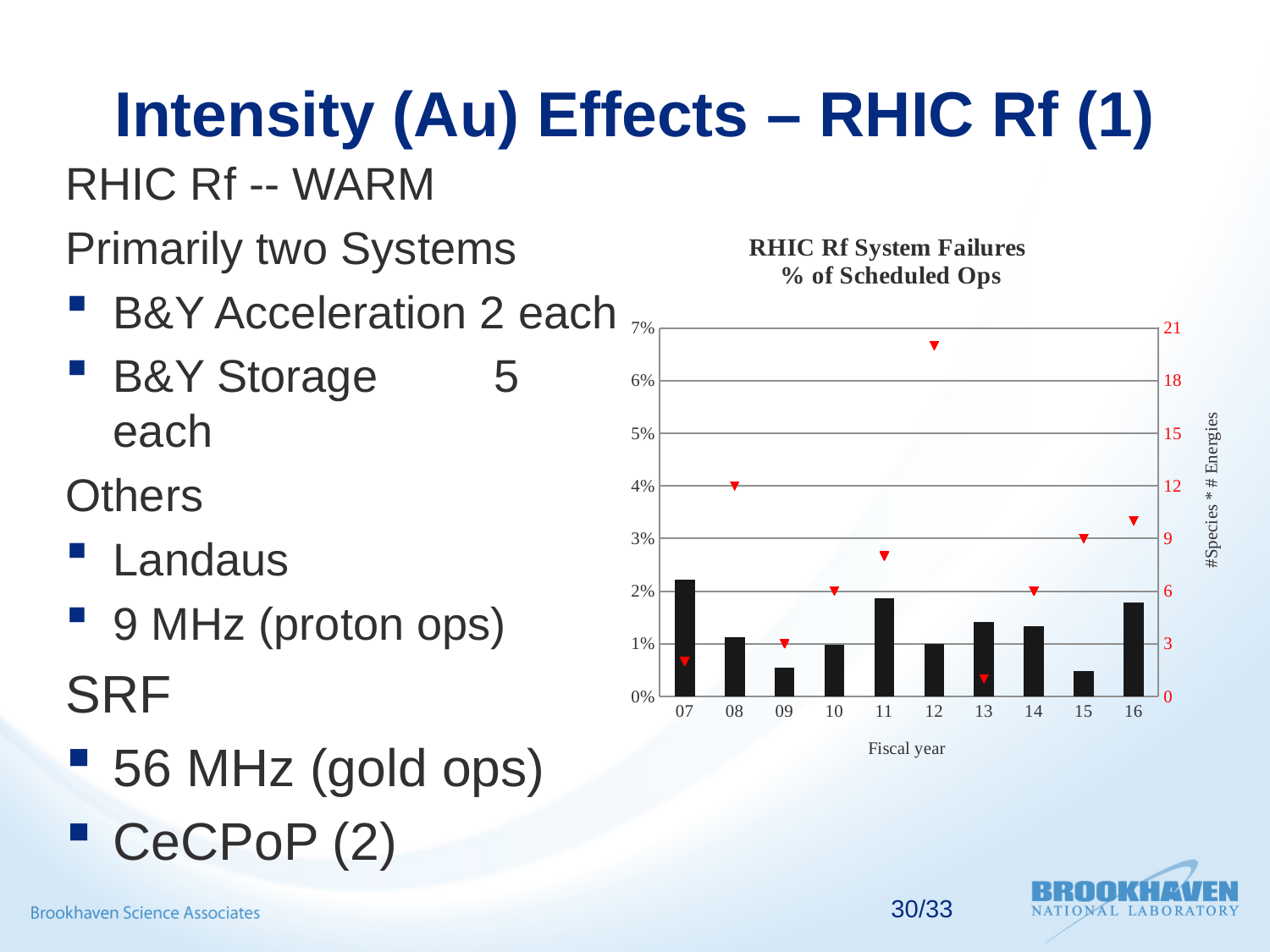
Which fiscal year has the tallest bar for Rf system failures as % of scheduled ops? 07 Which bar is taller, fiscal year 16 or fiscal year 15? 16 What is the label of the x axis of the chart? Fiscal year Is the bar for fiscal year 11 greater or less than 1%? greater What is the title of the chart? RHIC Rf System Failures % of Scheduled Ops How many fiscal years are shown on the x axis of the chart? 10 Which bar is taller, fiscal year 07 or fiscal year 08? 07 In which fiscal year is the red triangle marker (#Species * # Energies) highest? 12 Is the red triangle marker for fiscal year 12 greater or less than 18 on the right axis? greater Is the bar for fiscal year 07 greater or less than 2%? greater What kind of chart is shown on the slide? bar chart